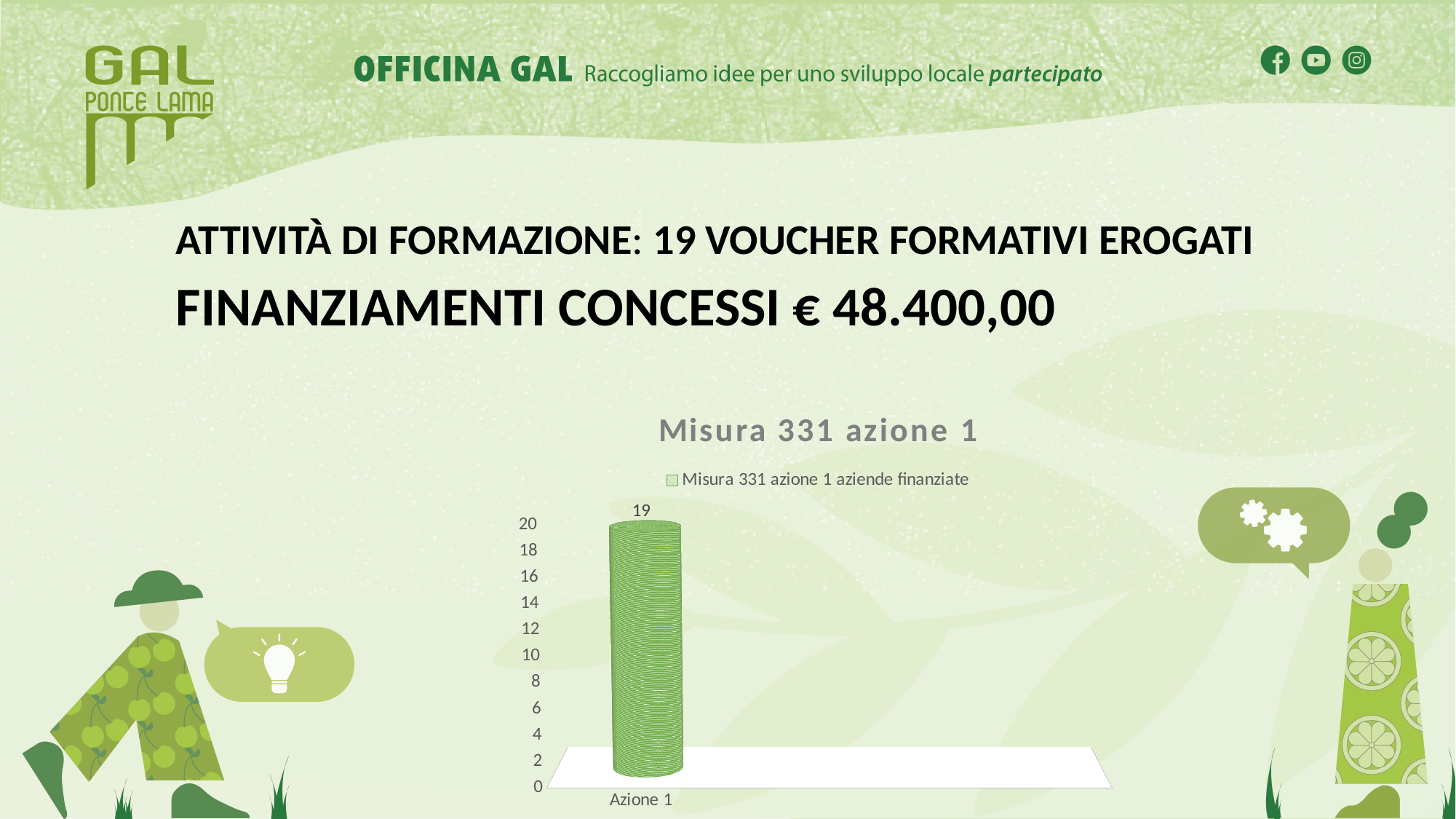
What is the label of the category on the x axis? Azione 1 Is the value for Azione 1 greater or less than 10? greater How many series does the legend list? 1 What is the title of the chart? Misura 331 azione 1 What is the value for Azione 1 in the chart? 19 What kind of chart is shown on the slide? bar chart How many categories are plotted on the x axis? 1 Is the value for Azione 1 greater or less than 20? less What is the highest value shown on the vertical axis? 20 What is the name of the series shown in the legend? Misura 331 azione 1 aziende finanziate